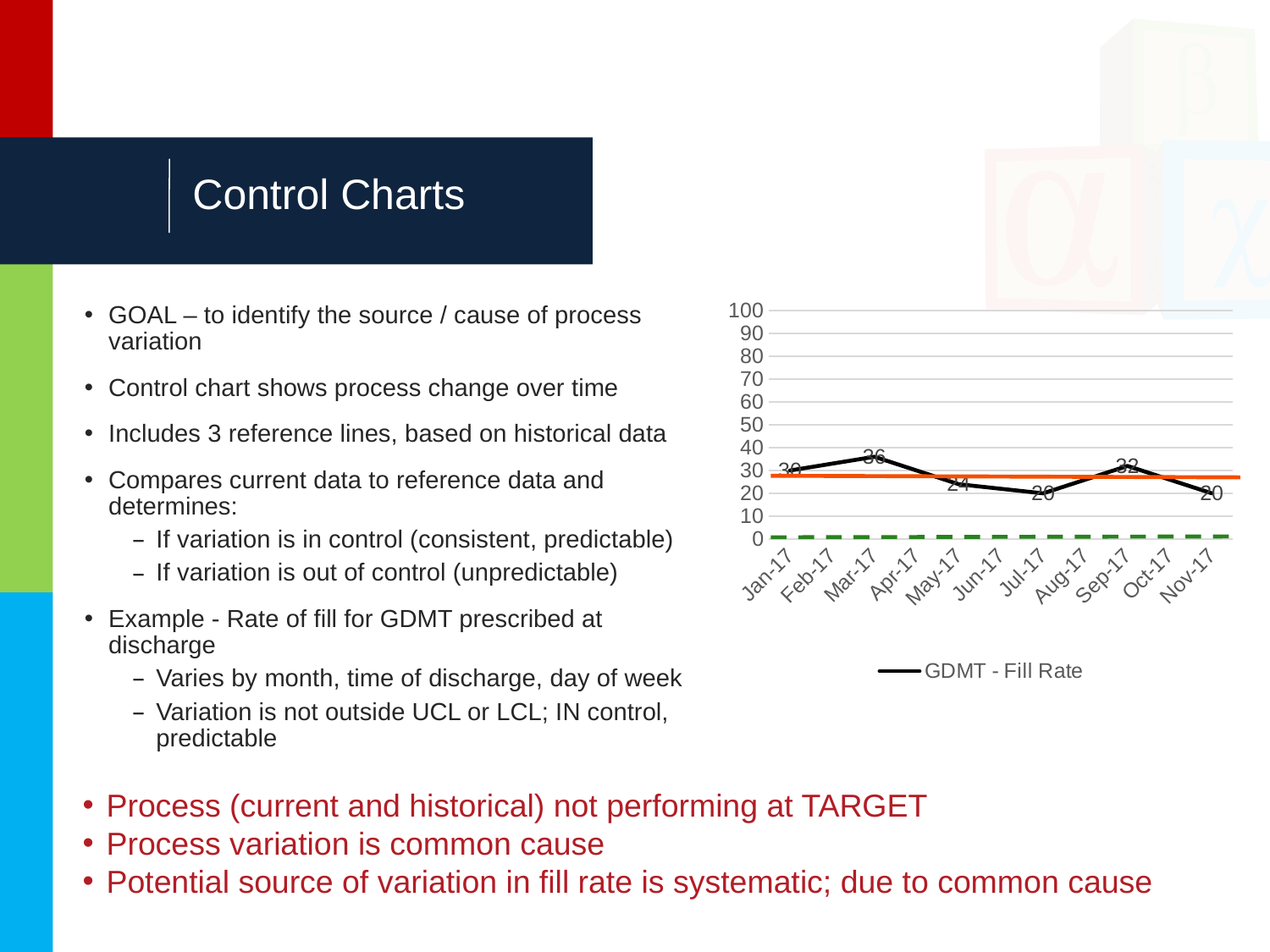
What is the GDMT - Fill Rate value for Mar-17? 36 Is the GDMT - Fill Rate value for Mar-17 greater or less than 50? less What is the lowest GDMT - Fill Rate value shown on the chart? 20 What is the difference between the GDMT - Fill Rate values for Sep-17 and Nov-17? 12 How many months are labelled on the x axis of the chart? 11 What is the GDMT - Fill Rate value for Jul-17? 20 Which month has the highest GDMT - Fill Rate value? Mar-17 What is the GDMT - Fill Rate value for Sep-17? 32 How many series does the chart legend list? 1 Which has a higher GDMT - Fill Rate value, Jan-17 or Sep-17? Sep-17 What is the difference between the GDMT - Fill Rate values for Mar-17 and Jul-17? 16 What kind of chart is shown on the slide? line chart